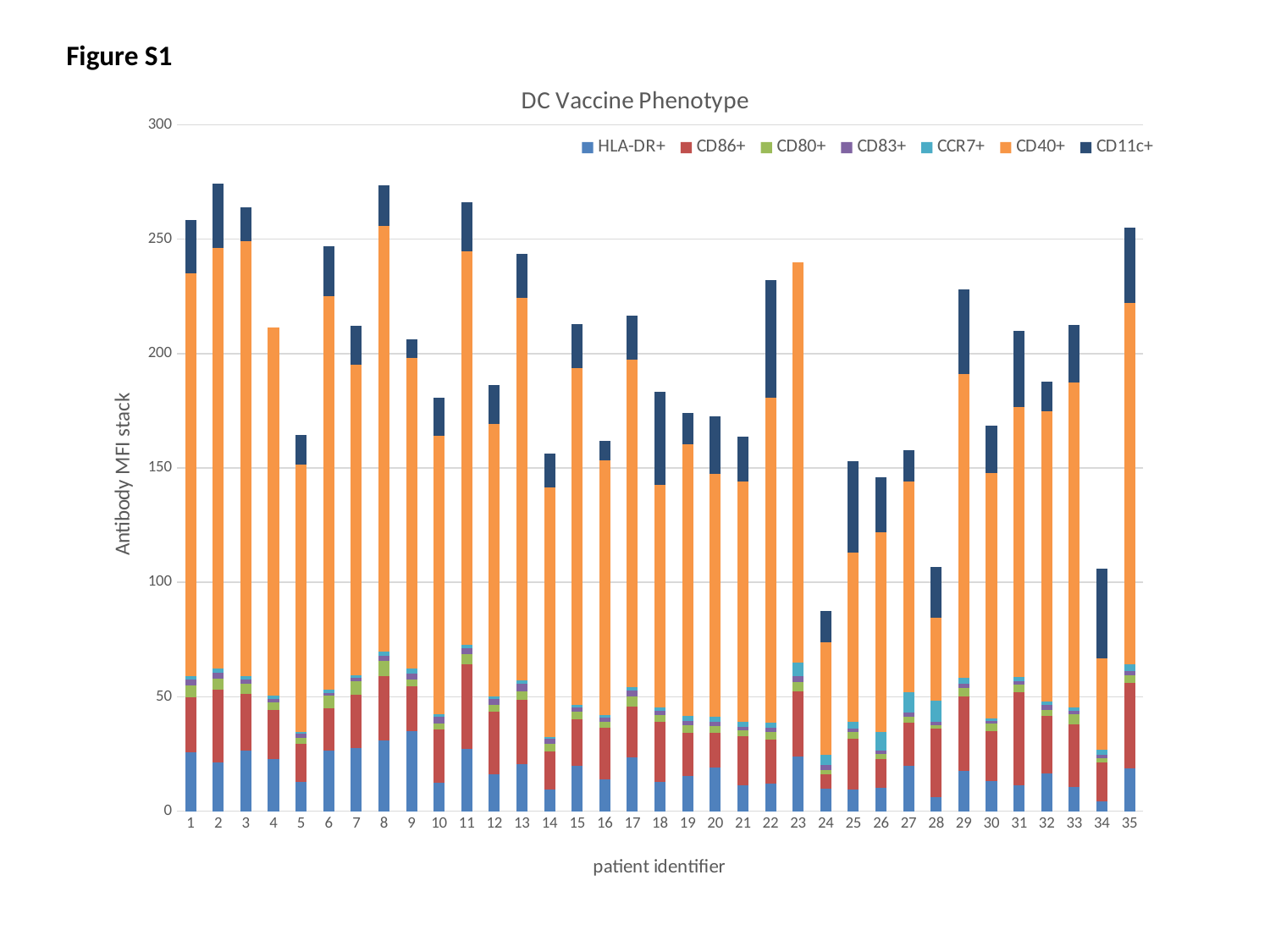
Which has the larger total stacked bar, patient 22 or patient 25? patient 22 Is the total stacked value for patient 24 greater or less than 100? less What is the title of the chart? DC Vaccine Phenotype Is the total stacked value for patient 1 greater or less than 250? greater Which patient identifier has the lowest total stacked bar? 24 Is the total stacked value for patient 34 greater or less than 150? less What kind of chart is shown on the slide? stacked bar chart How many series does the legend list? 7 What is the label of the y axis? Antibody MFI stack How many patient identifiers are plotted along the x axis? 35 Which has the larger total stacked bar, patient 3 or patient 10? patient 3